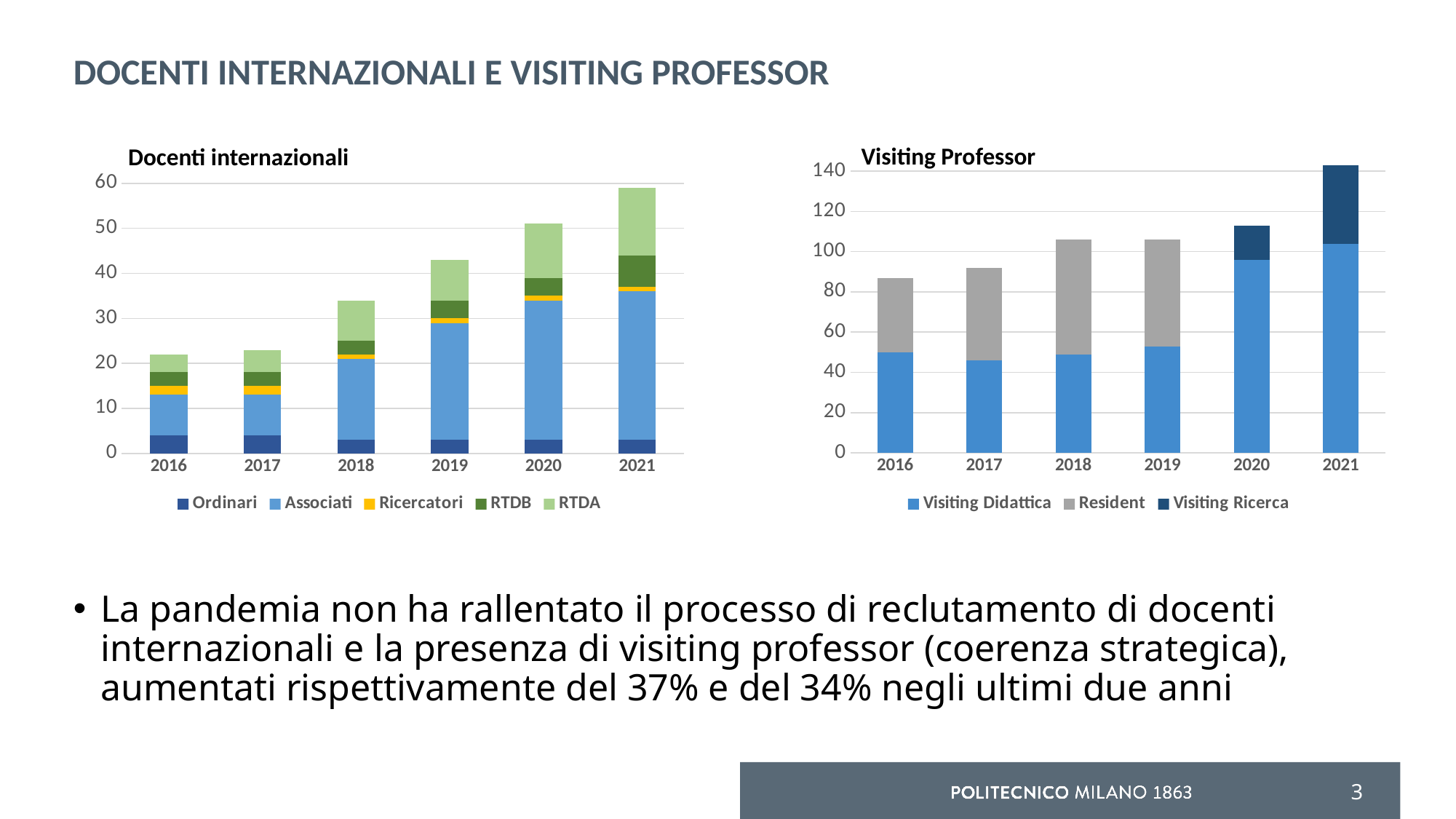
In the "Docenti internazionali" chart, is the total for 2021 greater or less than 50? greater What type of chart is the "Docenti internazionali" chart? stacked bar chart How many years are shown on the x axis of the "Visiting Professor" chart? 6 In the "Docenti internazionali" chart, is the total for 2018 greater or less than 30? greater In the "Visiting Professor" chart, is the total for 2021 greater or less than 120? greater In the "Docenti internazionali" chart, do the totals generally rise or fall from 2016 to 2021? rise In the "Visiting Professor" chart, which series is shown in grey? Resident In the "Docenti internazionali" chart, which year has the highest total? 2021 In the "Visiting Professor" chart, which year has the highest total? 2021 How many series does the legend of the "Docenti internazionali" chart list? 5 How many series does the legend of the "Visiting Professor" chart list? 3